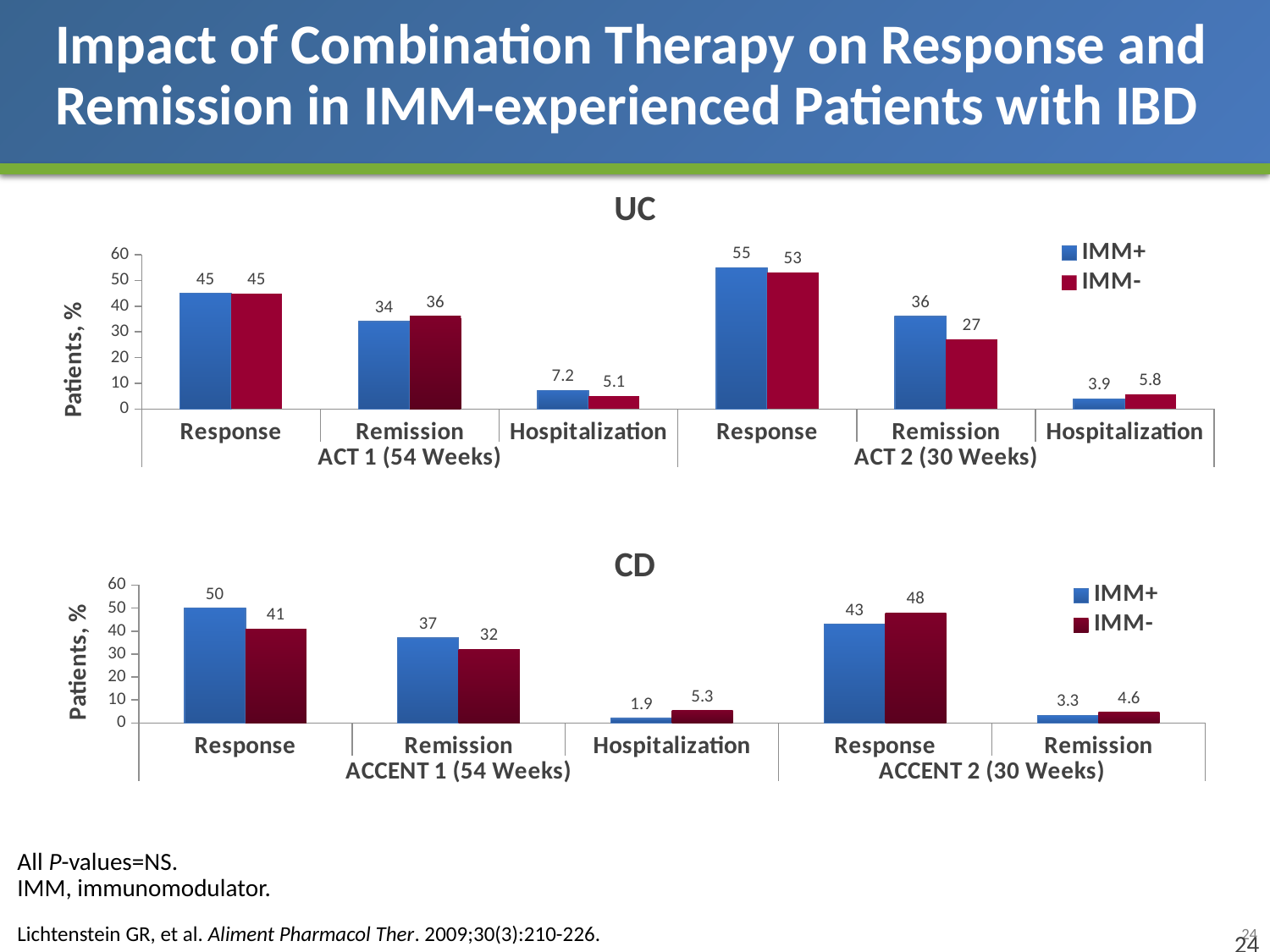
In the UC chart, what is the IMM- value for Remission in ACT 2 (30 Weeks)? 27 How many series does the legend of the UC chart list? 2 In the CD chart, what is the IMM+ value for Hospitalization in ACCENT 1 (54 Weeks)? 1.9 In the CD chart, what is the difference between the IMM+ and IMM- values for Response in ACCENT 1 (54 Weeks)? 9 In the CD chart, what is the IMM- value for Response in ACCENT 1 (54 Weeks)? 41 What kind of chart is the CD chart? Bar chart In the CD chart, which category has the lowest IMM+ value? Hospitalization (ACCENT 1, 54 Weeks) In the UC chart, what is the IMM+ value for Response in ACT 1 (54 Weeks)? 45 In the UC chart, which category has the highest IMM+ value? Response (ACT 2, 30 Weeks) In the UC chart, what is the difference between the IMM+ and IMM- values for Remission in ACT 2 (30 Weeks)? 9 In the CD chart, which is larger for Response in ACCENT 2 (30 Weeks), IMM+ or IMM-? IMM- In the UC chart, what is the IMM+ value for Hospitalization in ACT 1 (54 Weeks)? 7.2